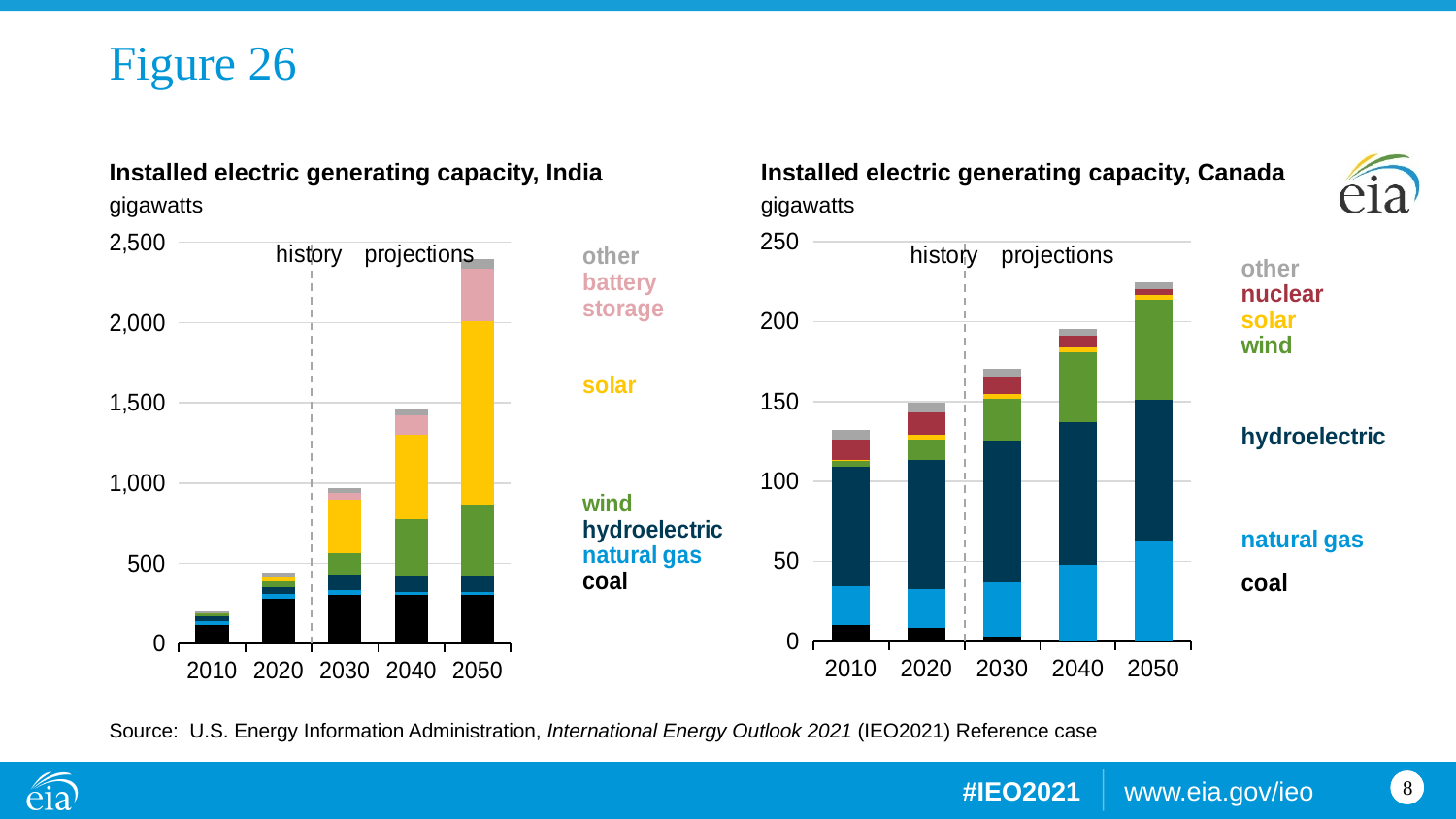
In the 'Installed electric generating capacity, Canada' chart, is the total capacity for 2050 greater or less than 200 gigawatts? greater In the 'Installed electric generating capacity, Canada' chart, do total installed capacities rise or fall from 2010 to 2050? rise How many series does the legend of the 'Installed electric generating capacity, India' chart list? 7 In the 'Installed electric generating capacity, Canada' chart, is the total capacity for 2010 greater or less than 150 gigawatts? less What kind of chart is the 'Installed electric generating capacity, India' chart? stacked bar chart In the 'Installed electric generating capacity, Canada' chart, which year has the lowest total installed capacity? 2010 In the 'Installed electric generating capacity, India' chart, is the total capacity for 2050 greater or less than 2,000 gigawatts? greater How many years are shown on the x axis of the 'Installed electric generating capacity, Canada' chart? 5 In the 'Installed electric generating capacity, India' chart, which year has the highest total installed capacity? 2050 Which series appears in the legend of the Canada chart but not in the legend of the India chart? nuclear What unit is used on the y axis of both charts? gigawatts